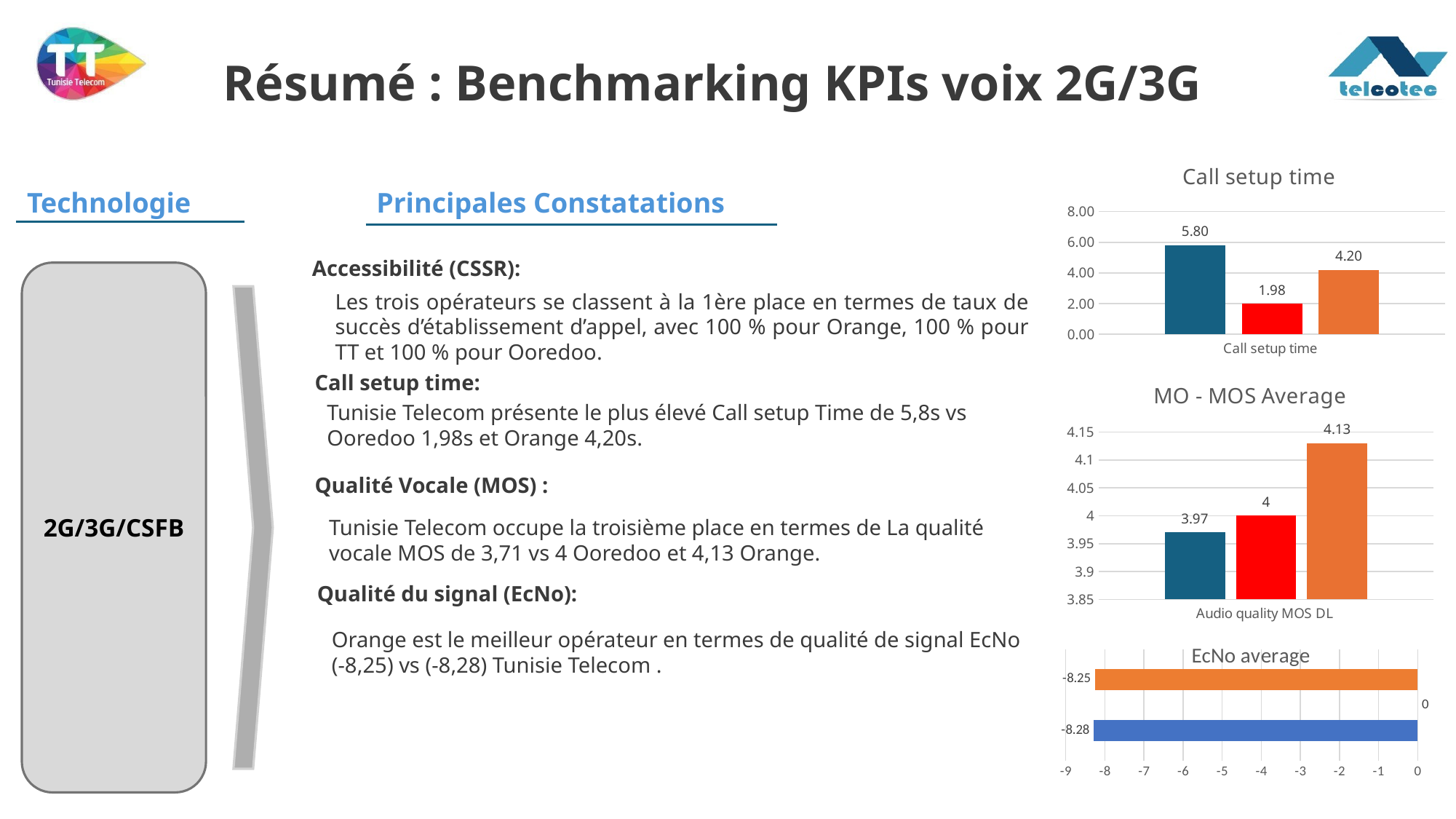
In the MO - MOS Average chart, what is the value of the dark blue bar? 3.97 In the Call setup time chart, what is the value shown on the tallest bar? 5.80 In the MO - MOS Average chart, what is the value of the orange bar? 4.13 In the Call setup time chart, what is the value shown on the shortest bar? 1.98 In the EcNo average chart, what is the value of the orange bar? -8.25 In the MO - MOS Average chart, which is larger: the red bar or the dark blue bar? the red bar What kind of chart is the Call setup time chart? bar chart In the MO - MOS Average chart, what is the difference between the orange bar (4.13) and the dark blue bar (3.97)? 0.16 In the Call setup time chart, what is the value of the orange bar? 4.20 What is the x-axis category label shown under the bars in the MO - MOS Average chart? Audio quality MOS DL How many bars are plotted in the Call setup time chart? 3 In the Call setup time chart, what is the difference between the highest bar (5.80) and the lowest bar (1.98)? 3.82